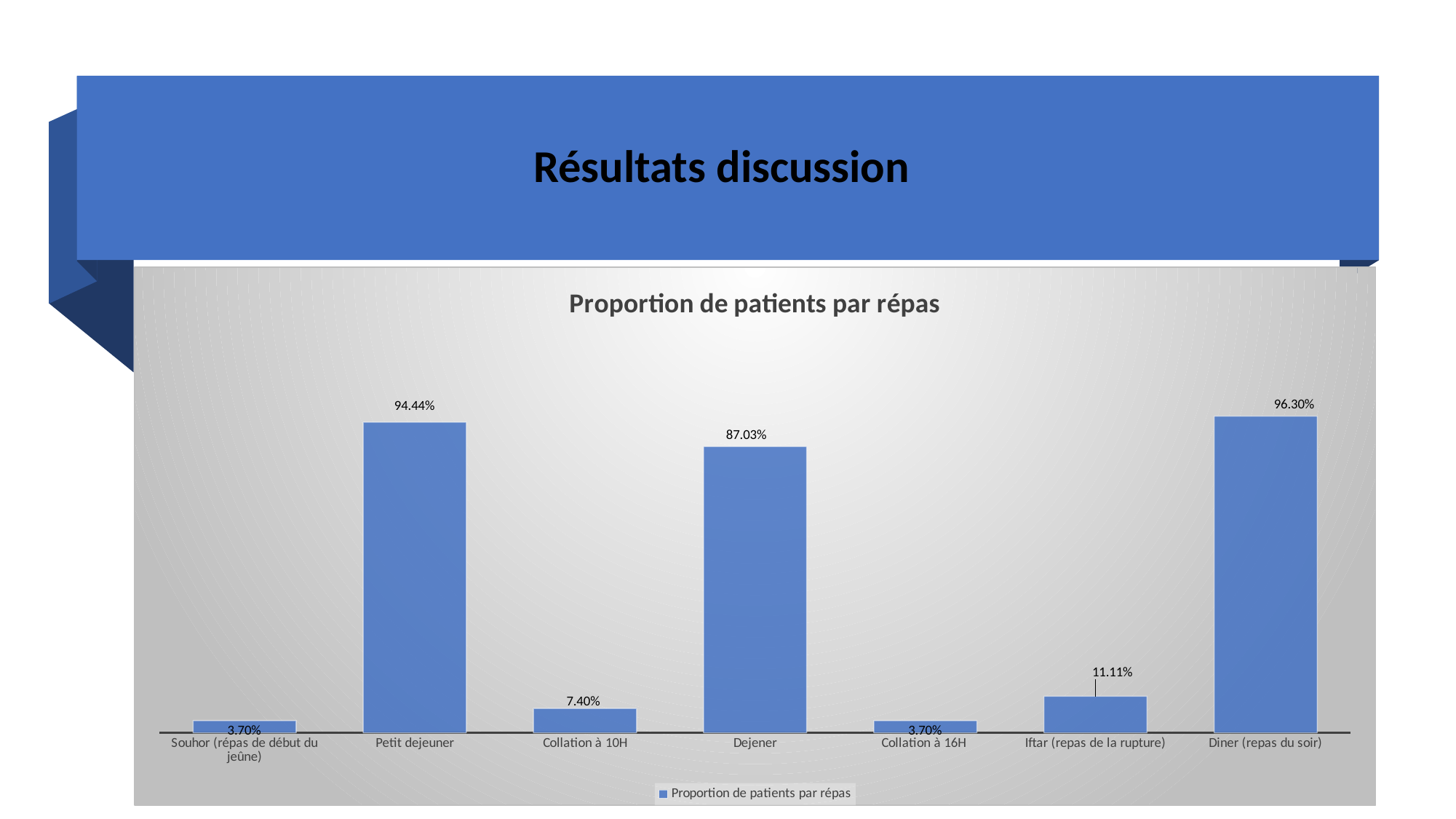
What is the difference between the values for Iftar (repas de la rupture) and Collation à 10H? 3.71% What is the value for Iftar (repas de la rupture)? 11.11% What is the value for Dejener? 87.03% Which is larger, the value for Petit dejeuner or the value for Dejener? Petit dejeuner Which category has the highest value? Diner (repas du soir) How many categories are shown on the x axis? 7 How many series does the legend list? 1 What is the difference between the values for Diner (repas du soir) and Petit dejeuner? 1.86% What is the value for Petit dejeuner? 94.44% What kind of chart is shown? bar chart What is the title of the chart? Proportion de patients par répas What is the value for Collation à 10H? 7.40%